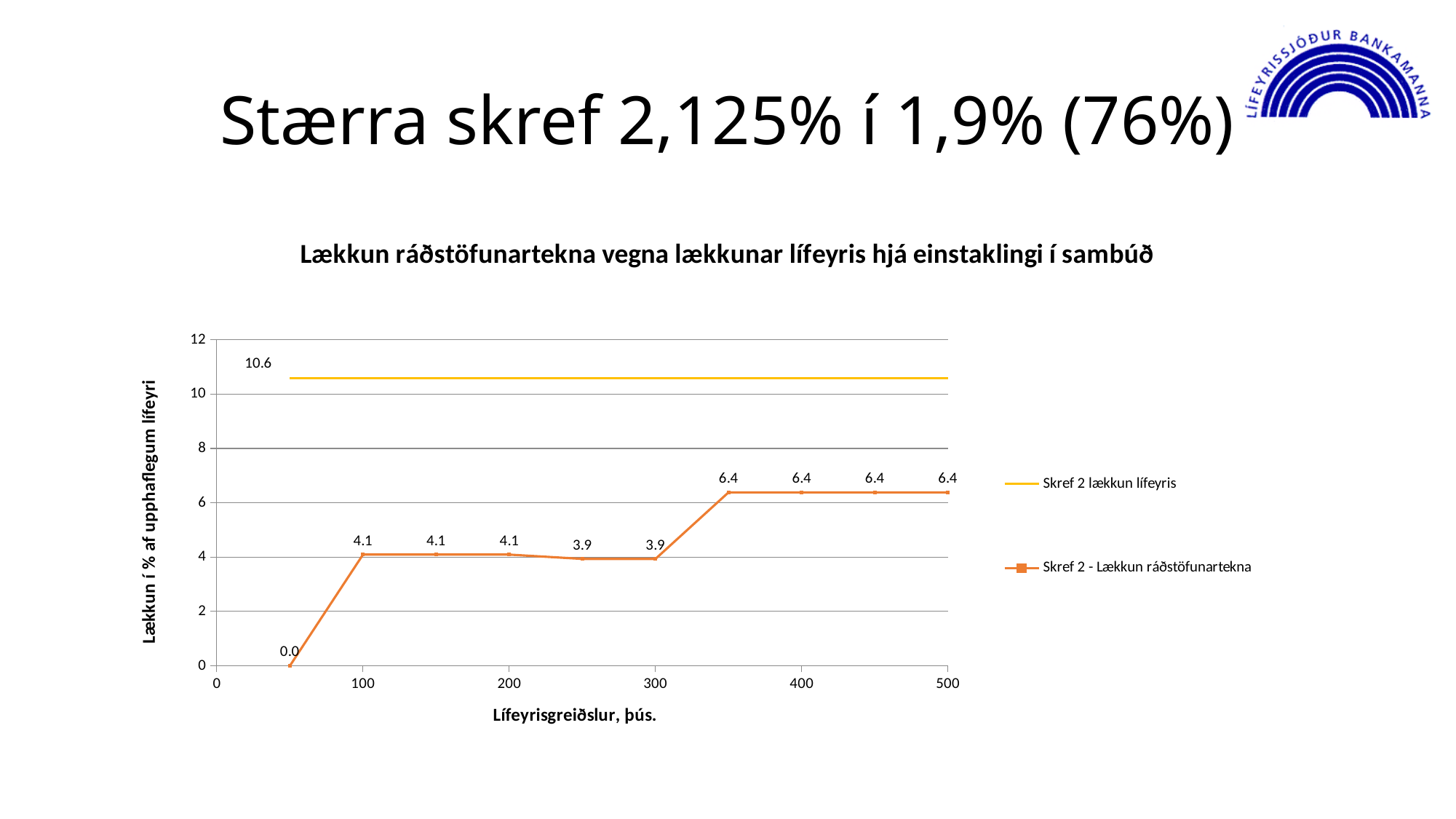
What is the lowest labelled value of the 'Skref 2 - Lækkun ráðstöfunartekna' series? 0.0 What type of chart is shown on the slide? line chart What is the value of 'Skref 2 - Lækkun ráðstöfunartekna' at 250 on the x axis? 3.9 Which series has the higher value at 300 on the x axis: 'Skref 2 lækkun lífeyris' or 'Skref 2 - Lækkun ráðstöfunartekna'? Skref 2 lækkun lífeyris How many labelled data points does the 'Skref 2 - Lækkun ráðstöfunartekna' series have? 10 What is the title of the chart? Lækkun ráðstöfunartekna vegna lækkunar lífeyris hjá einstaklingi í sambúð What is the value of 'Skref 2 - Lækkun ráðstöfunartekna' at 100 on the x axis? 4.1 What is the difference between the 'Skref 2 lækkun lífeyris' value (10.6) and the 'Skref 2 - Lækkun ráðstöfunartekna' value at 400 (6.4)? 4.2 How many series does the legend list? 2 What is the value of the 'Skref 2 lækkun lífeyris' series? 10.6 What is the value of 'Skref 2 - Lækkun ráðstöfunartekna' at 500 on the x axis? 6.4 What is the highest labelled value of the 'Skref 2 - Lækkun ráðstöfunartekna' series? 6.4